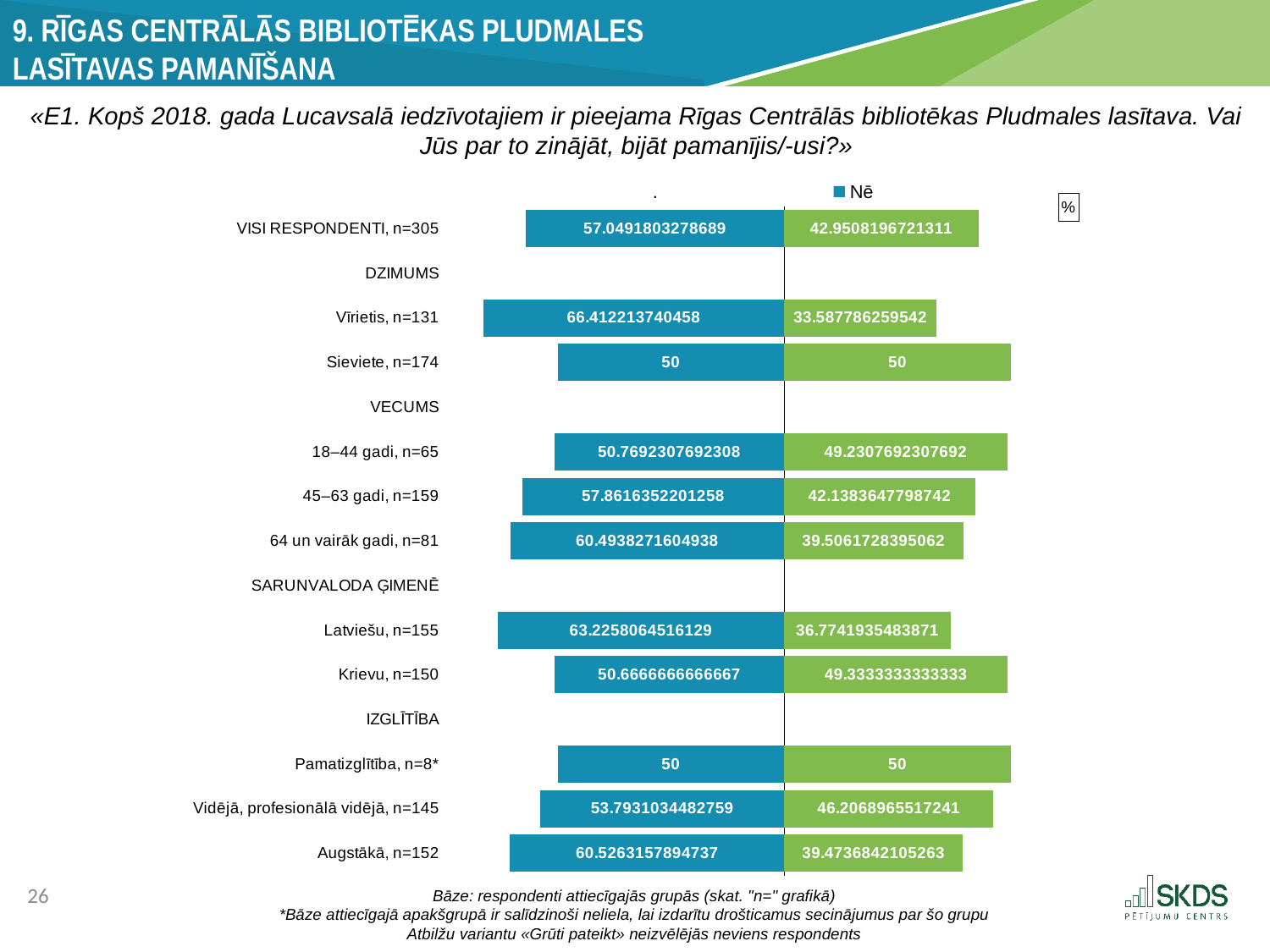
How many respondent groups have bars plotted in the chart? 11 Which group has the larger "Nē" value: "Latviešu, n=155" or "Krievu, n=150"? Latviešu, n=155 Which group has the highest value in the blue (left) series? Vīrietis, n=131 What is the value of the "Nē" series for "Latviešu, n=155"? 63.2258064516129 What is the value of the blue (left) series for "Vīrietis, n=131"? 66.412213740458 How many series does the legend list? 2 What kind of chart is shown on the slide? bar chart What is the value of the "Nē" series for "VISI RESPONDENTI, n=305"? 57.0491803278689 What is the value of the blue (left) series for "Augstākā, n=152"? 60.5263157894737 What is the total of the two bar segments for "Augstākā, n=152"? 100